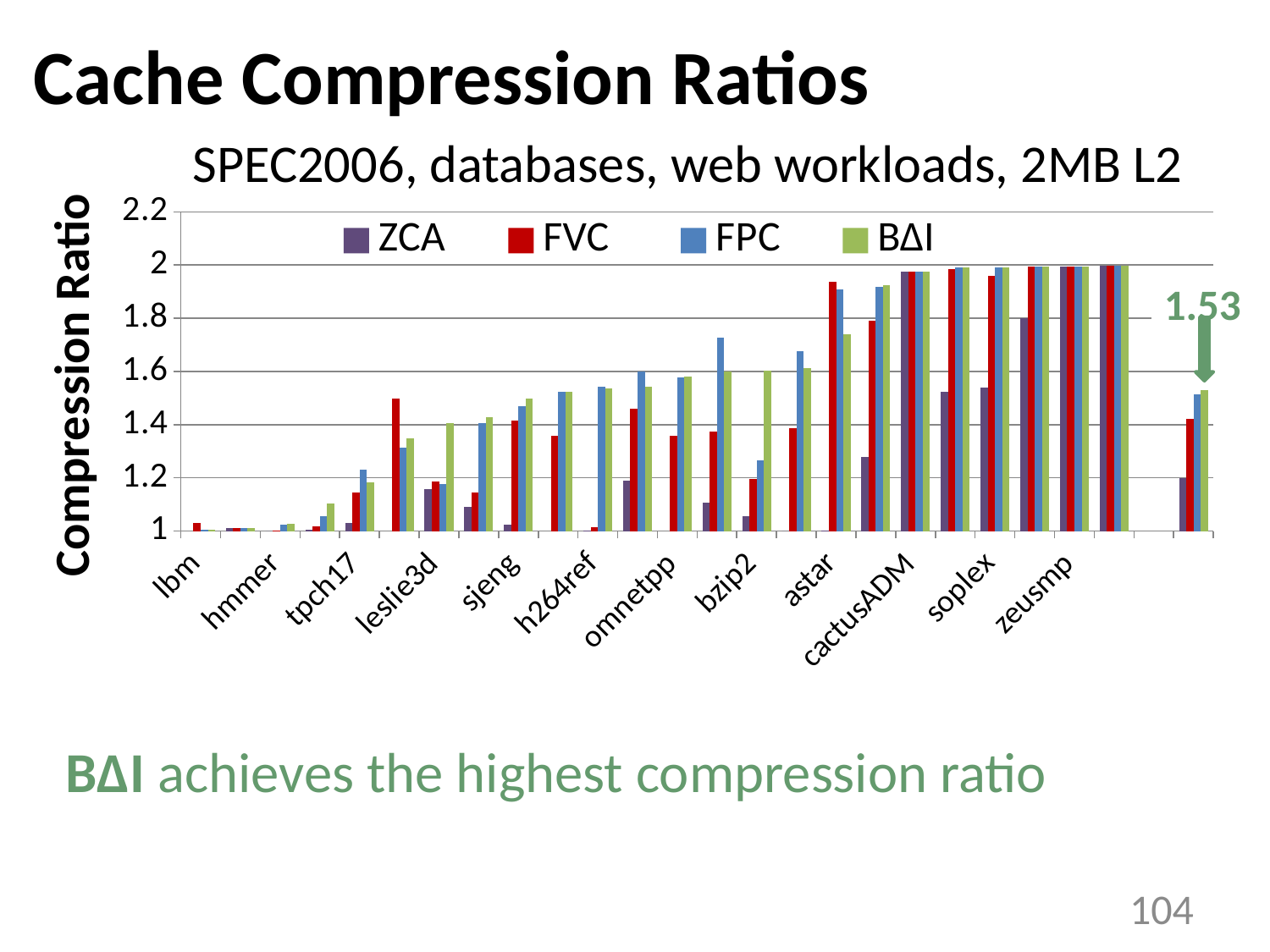
How many series does the chart legend list? 4 Do the BΔI values generally rise or fall moving from left to right along the x axis? rise What is the highest tick value shown on the vertical axis? 2.2 Is the ZCA value for lbm greater or less than 1.2? less What kind of chart is shown on the slide? bar chart What value is printed as a data label above the rightmost group of bars? 1.53 What is the title printed above the chart? SPEC2006, databases, web workloads, 2MB L2 How many category labels are printed along the x axis? 12 Which series does the slide state achieves the highest compression ratio? BΔI Is the FVC value for lbm greater or less than 1.2? less What is the label on the vertical axis of the chart? Compression Ratio What is the lowest value shown on the vertical axis? 1